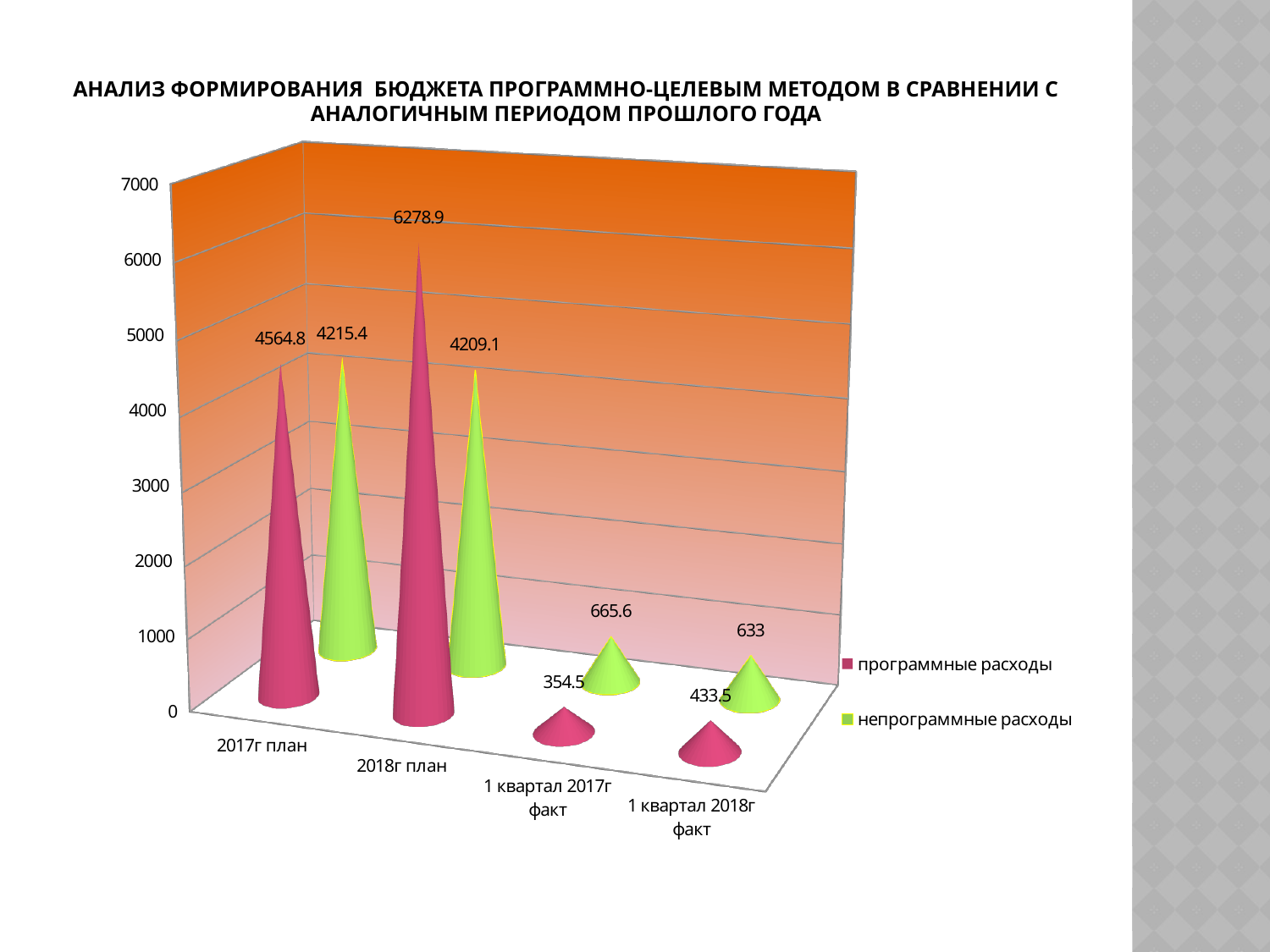
How many series does the legend list? 2 What is the difference between непрограммные расходы and программные расходы for 1 квартал 2017г факт? 311.1 For 1 квартал 2018г факт, which is larger: программные расходы or непрограммные расходы? непрограммные расходы Which category has the lowest value for непрограммные расходы? 1 квартал 2018г факт What colour represents программные расходы in the chart? Pink How many categories are shown on the x axis? 4 What is the difference between программные расходы for 2018г план and 2017г план? 1714.1 What is the value of непрограммные расходы for 2017г план? 4215.4 What is the value of программные расходы for 2018г план? 6278.9 What is the value of программные расходы for 1 квартал 2017г факт? 354.5 What is the value of непрограммные расходы for 1 квартал 2018г факт? 633 Which category has the highest value for программные расходы? 2018г план